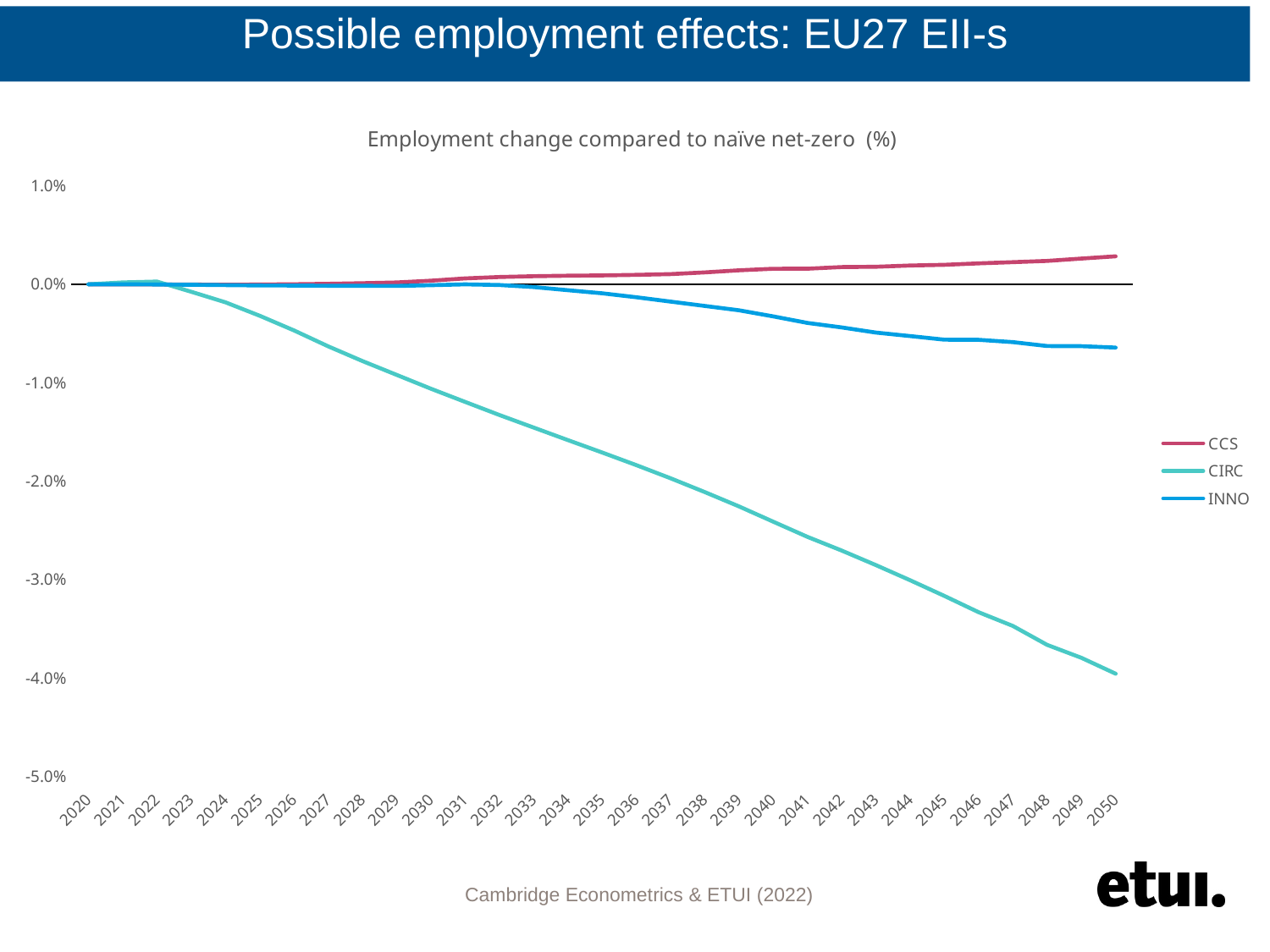
Which series has the highest value in 2050? CCS Does the CCS line rise or fall from 2020 to 2050? rise Which series has the lowest value in 2050? CIRC In 2050, which is larger, the value for INNO or the value for CIRC? INNO Is the value for CIRC in 2050 greater or less than -3.0%? less How many years are shown along the x axis? 31 Is the value for CCS in 2050 greater or less than 1.0%? less Is the value for INNO in 2050 greater or less than -1.0%? greater What kind of chart is shown on the slide? line chart How many series does the legend list? 3 What is the title of the chart? Employment change compared to naïve net-zero (%) Does the CIRC line rise or fall from 2020 to 2050? fall